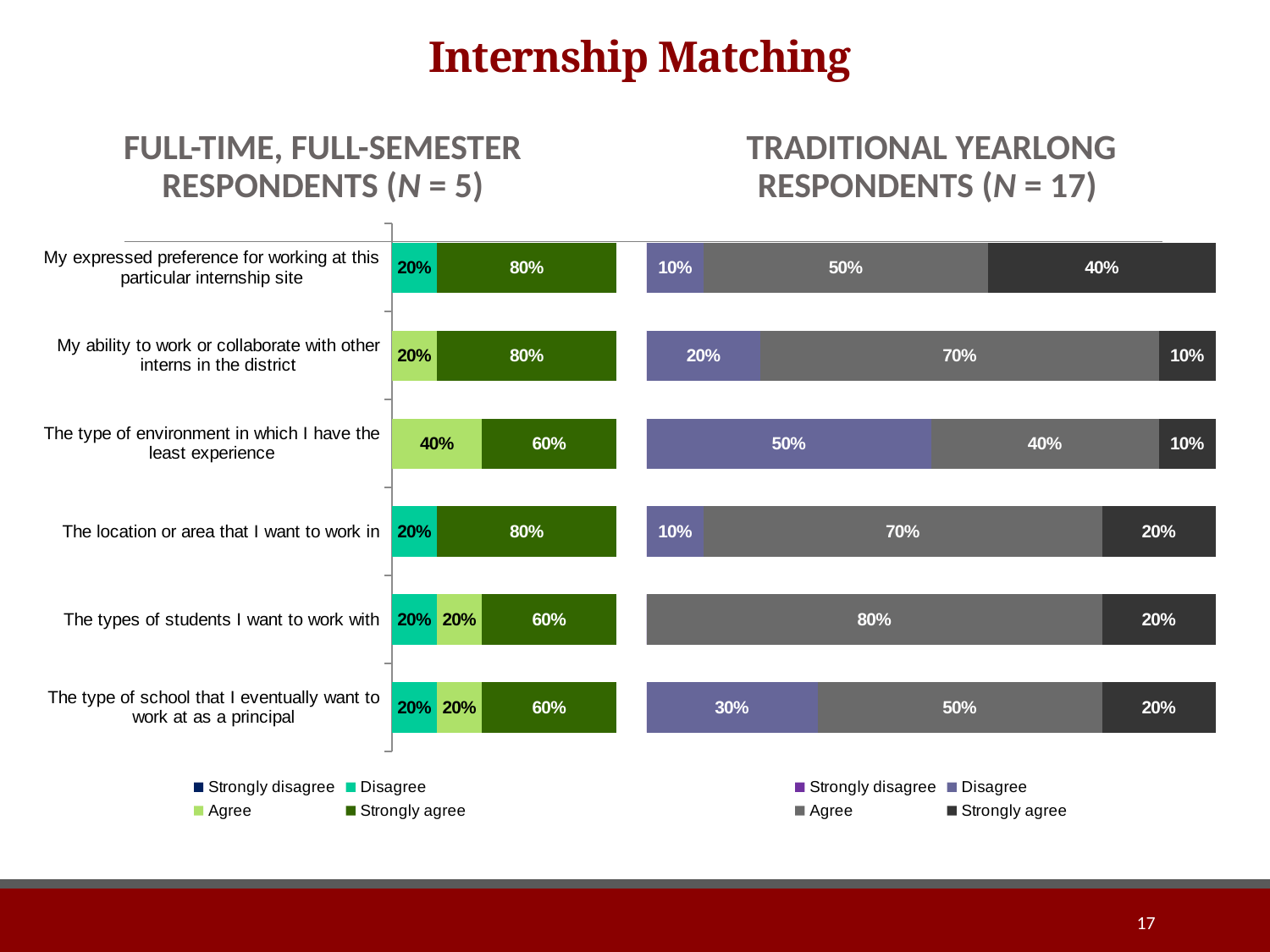
In the Traditional Yearlong Respondents chart, what percentage of respondents chose Agree for "The types of students I want to work with"? 80% In the Full-Time, Full-Semester Respondents chart, what is the combined total of Disagree and Agree for "The type of school that I eventually want to work at as a principal"? 40% How many items (categories) are listed in the Full-Time, Full-Semester Respondents chart? 6 In the Traditional Yearlong Respondents chart, which item has the highest Disagree percentage? The type of environment in which I have the least experience In the Full-Time, Full-Semester Respondents chart, what percentage chose Strongly agree for "The type of environment in which I have the least experience"? 60% What type of chart is the Traditional Yearlong Respondents chart? Stacked bar chart In the Full-Time, Full-Semester Respondents chart, is the Strongly agree percentage larger for "The location or area that I want to work in" or for "The types of students I want to work with"? The location or area that I want to work in How many series does the legend of the Traditional Yearlong Respondents chart list? 4 In the Traditional Yearlong Respondents chart, what percentage chose Strongly agree for "My expressed preference for working at this particular internship site"? 40% In the Traditional Yearlong Respondents chart, what is the difference between the Agree percentage for "The types of students I want to work with" and the Agree percentage for "The type of school that I eventually want to work at as a principal"? 30% In the Traditional Yearlong Respondents chart, what percentage chose Disagree for "The type of school that I eventually want to work at as a principal"? 30% In the Traditional Yearlong Respondents chart, which item has the lowest Strongly agree percentage? Two items tie at 10%: My ability to work or collaborate with other interns in the district, and The type of environment in which I have the least experience